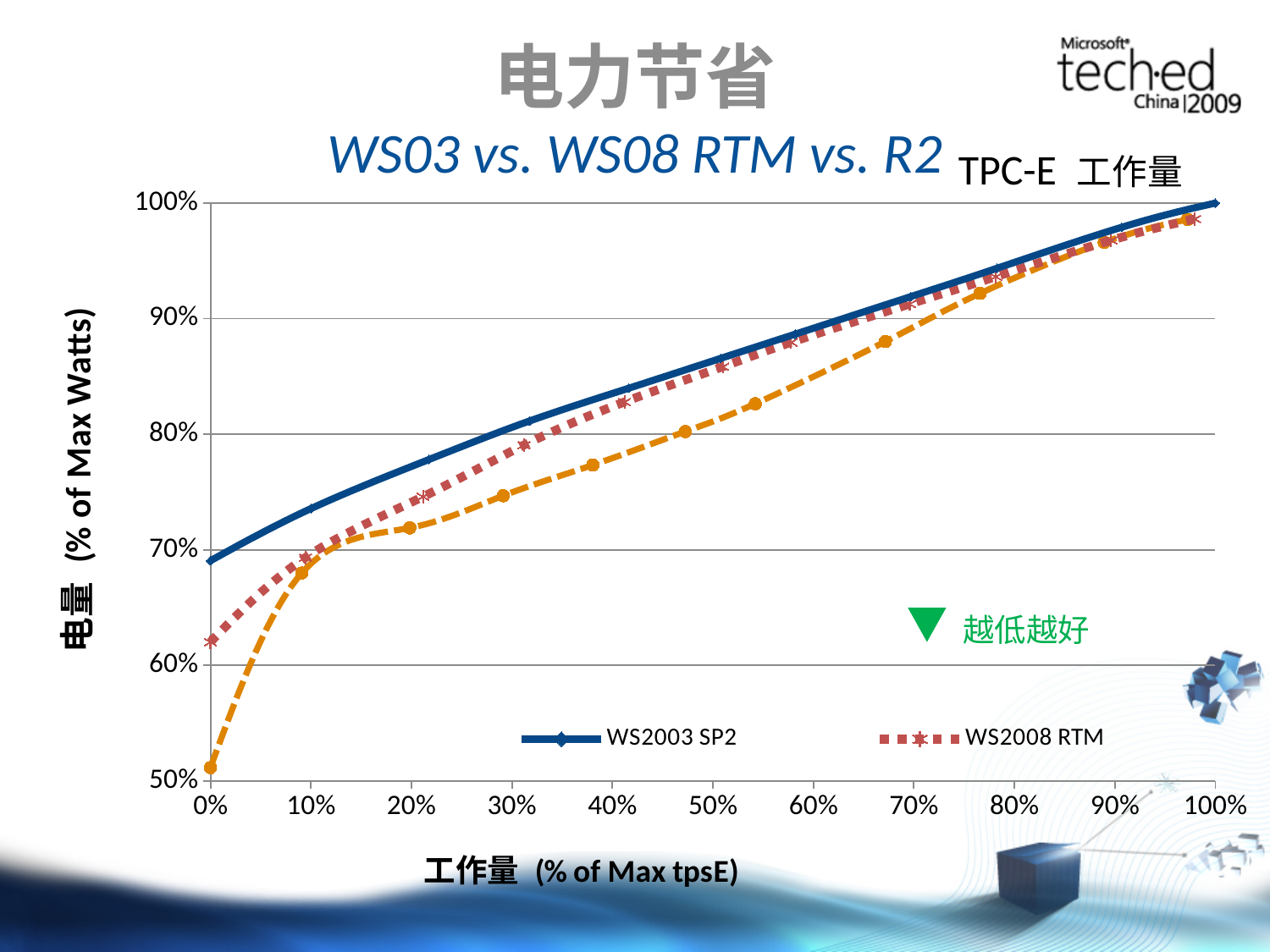
How many tick marks are labelled on the x axis? 11 What is the value for WS2003 SP2 at 100% workload? 100% At 0% workload, which is larger: the value for WS2003 SP2 or the value for WS2008 RTM? WS2003 SP2 How many series does the chart's legend list? 2 Is the value for WS2008 RTM at 50% workload greater or less than 80%? greater Is the value for WS2003 SP2 at 80% workload greater or less than 90%? greater What kind of chart is shown on the slide? line chart Is the value for WS2008 RTM at 0% workload greater or less than 70%? less Which series does the solid blue line represent? WS2003 SP2 What is the label of the y axis? 电量 (% of Max Watts) Do the values for WS2003 SP2 rise or fall as workload increases along the x axis? rise